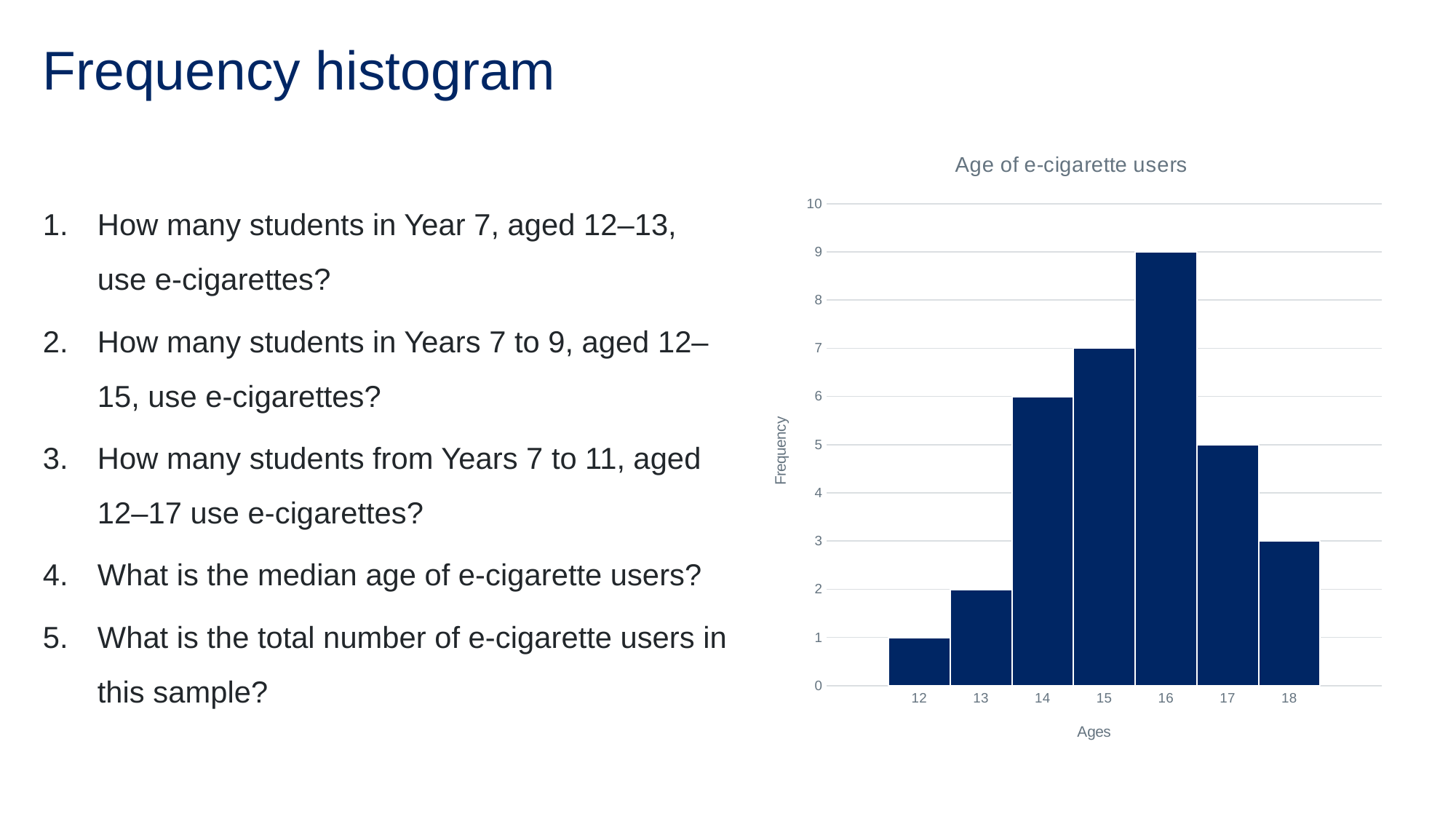
How many age categories are shown on the x axis of the chart? 7 What kind of chart is shown on the slide? bar chart Which has a higher frequency, age 15 or age 18? 15 Which age has the highest frequency in the Age of e-cigarette users chart? 16 Do the frequencies rise or fall from age 16 to age 18? fall Which age has the lowest frequency in the Age of e-cigarette users chart? 12 What is the difference between the frequencies for age 16 and age 17? 4 Is the frequency for age 13 greater or less than 5? less What is the frequency for age 14 in the Age of e-cigarette users chart? 6 What is the frequency for age 16 in the Age of e-cigarette users chart? 9 What is the frequency for age 12 in the Age of e-cigarette users chart? 1 What is the title of the chart on the slide? Age of e-cigarette users